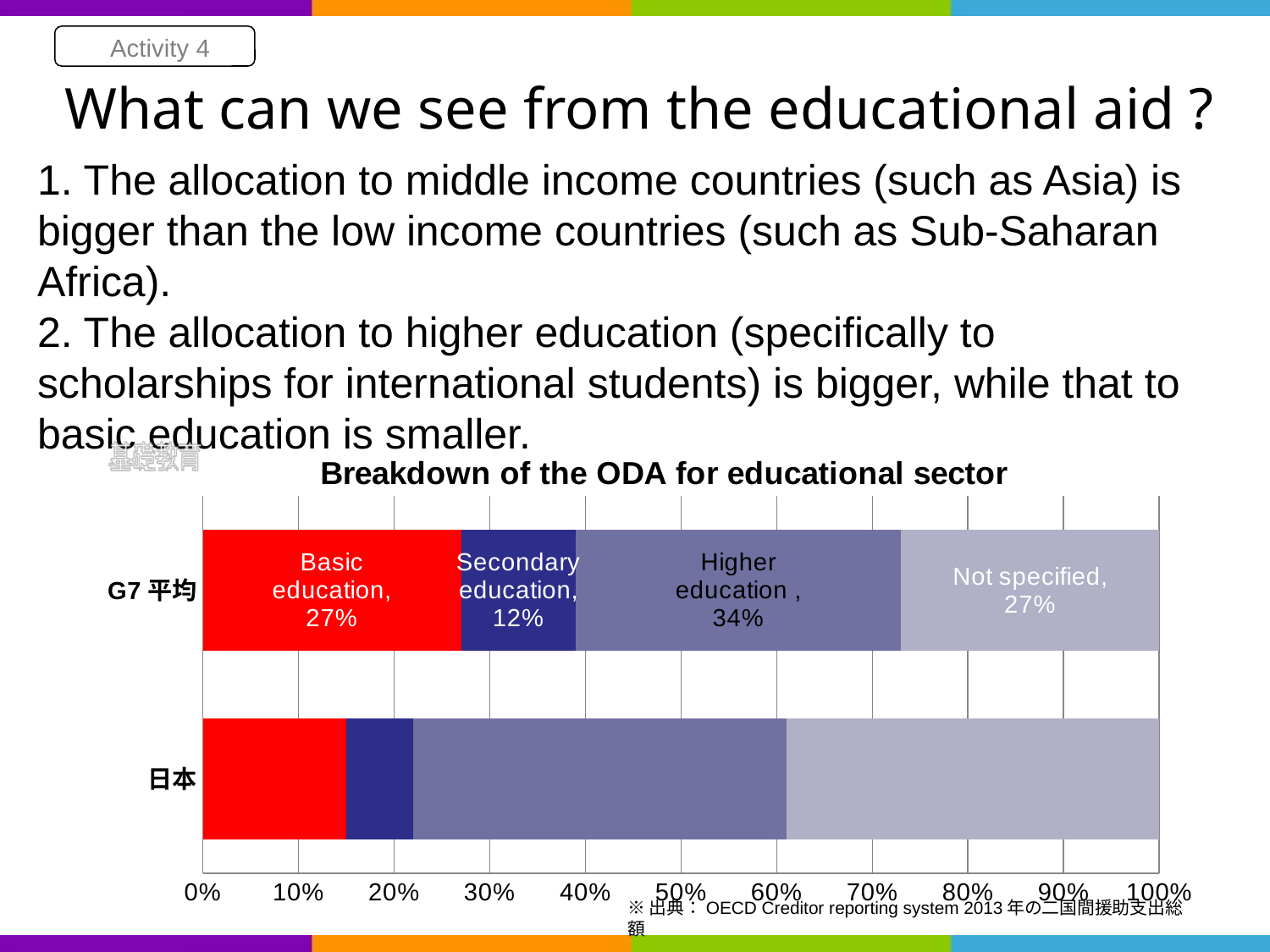
What share of the G7 平均 bar is Not specified? 27% In the G7 平均 bar, how many percentage points larger is Higher education than Secondary education? 22 percentage points Is the Basic education share for 日本 greater or less than 20%? less What share of the G7 平均 bar is Higher education? 34% What share of the G7 平均 bar is Basic education? 27% Which segment of the G7 平均 bar is the smallest? Secondary education What share of the G7 平均 bar is Secondary education? 12% What is the title of the chart on the slide? Breakdown of the ODA for educational sector Which bar has the larger Basic education share, G7 平均 or 日本? G7 平均 What type of chart is shown under the title "Breakdown of the ODA for educational sector"? Stacked bar chart How many bars (categories) does the chart show? 2 Which segment of the G7 平均 bar is the largest? Higher education